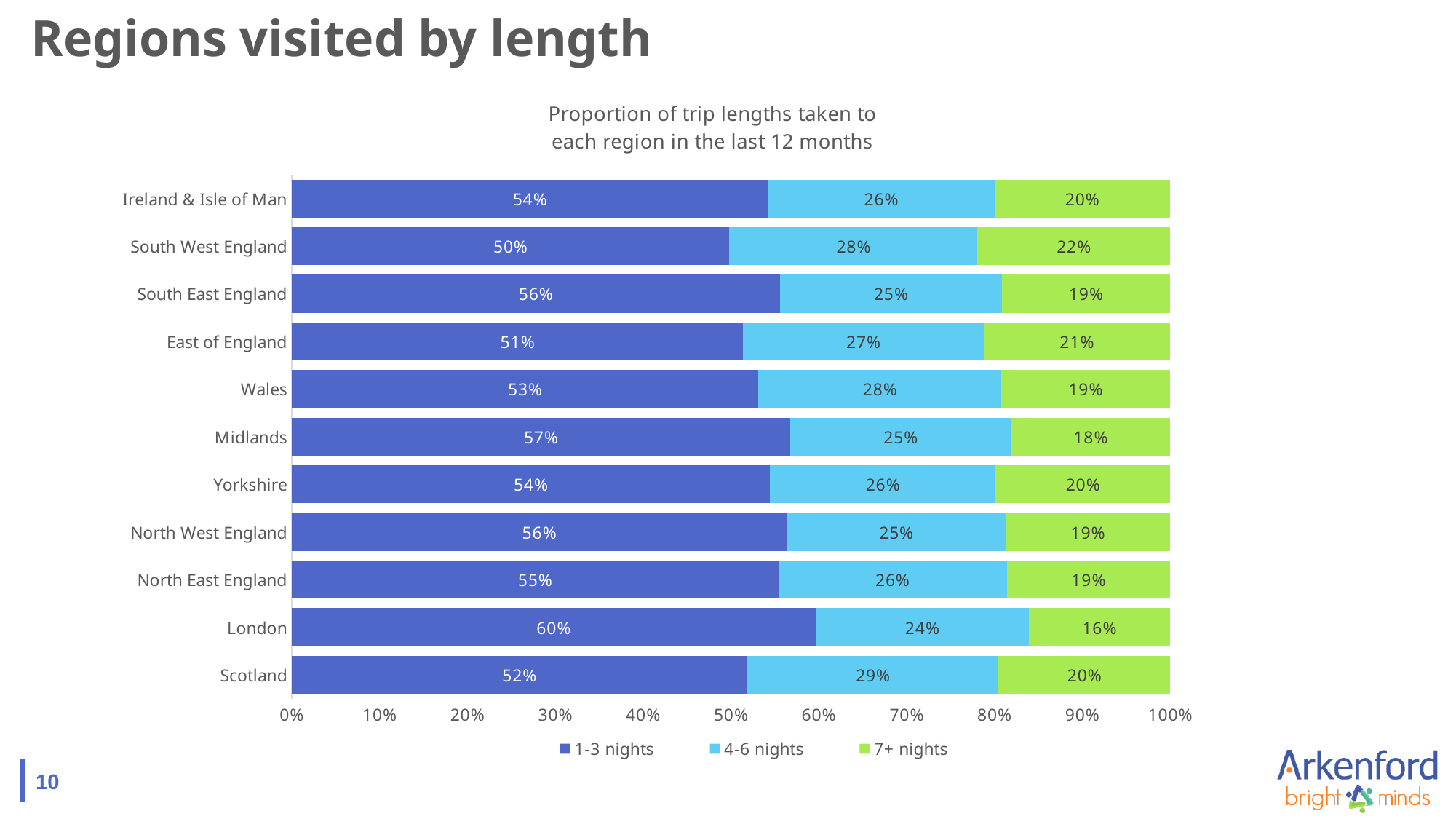
Which is larger: the 7+ nights share for East of England or for Midlands? East of England What is the difference between the 1-3 nights share for London and for South West England? 10 percentage points What is the title of the chart? Proportion of trip lengths taken to each region in the last 12 months Which region has the lowest share of 7+ night trips? London What percentage of trips to Scotland were 4-6 nights? 29% What type of chart is shown on the slide? Stacked bar chart What percentage of trips to South West England were 7+ nights? 22% Which region has the highest share of 1-3 night trips? London How many regions are shown in the chart? 11 How many series does the legend list? 3 What percentage of trips to London were 1-3 nights? 60% Which region has the highest share of 4-6 night trips? Scotland